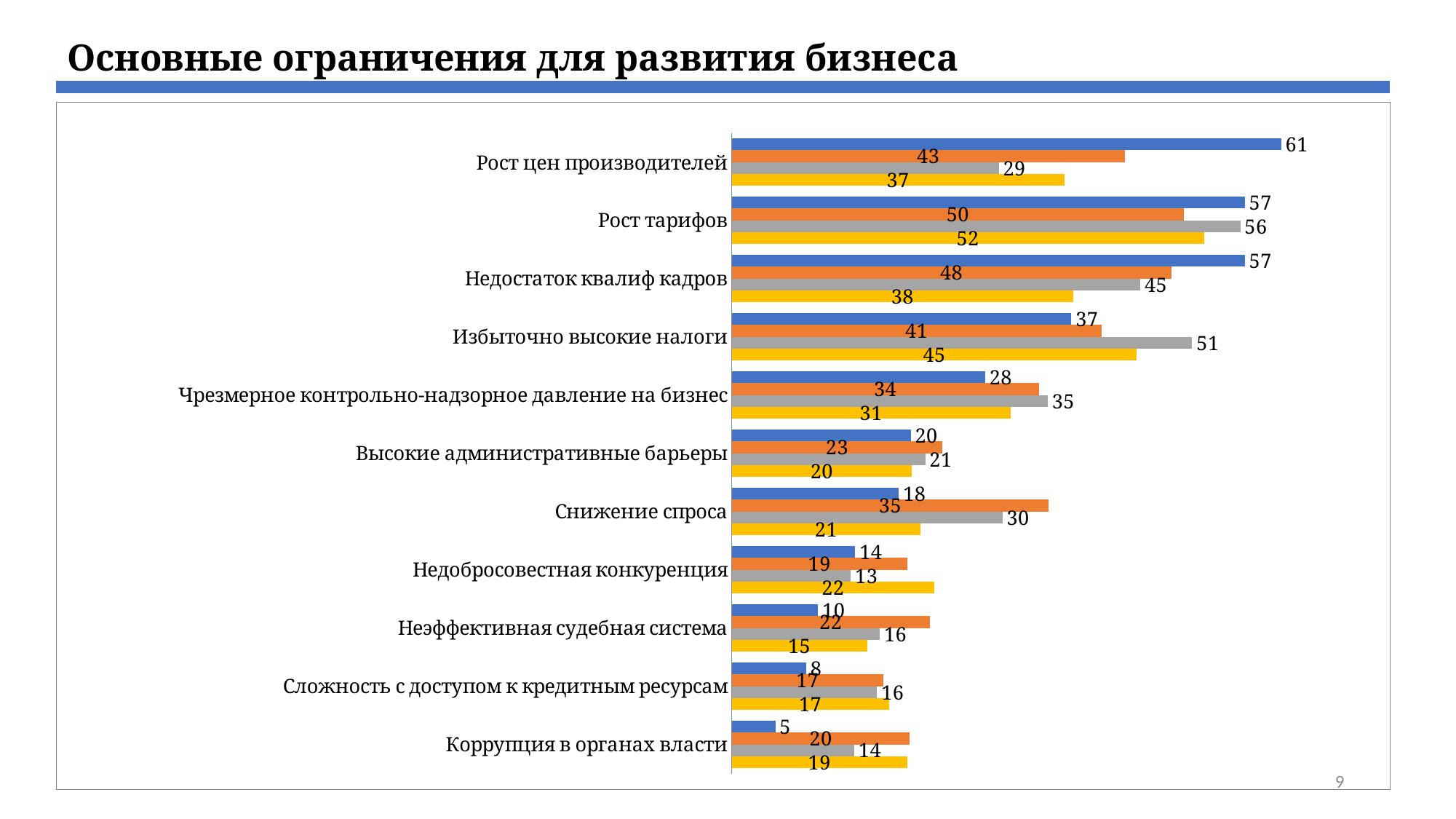
What is the value of the yellow bar for 'Рост тарифов'? 52 Which is larger for 'Избыточно высокие налоги': the blue bar or the gray bar? the gray bar What is the difference between the blue bar and the gray bar for 'Рост цен производителей'? 32 Which category has the highest blue bar value? Рост цен производителей What is the value of the blue bar for 'Рост цен производителей'? 61 How many bars are shown for each category on the chart? 4 Which category has the lowest blue bar value? Коррупция в органах власти How many categories (business constraints) are listed on the chart? 11 What is the difference between the orange bar and the blue bar for 'Коррупция в органах власти'? 15 What is the value of the orange bar for 'Снижение спроса'? 35 What type of chart is shown on the slide? bar chart What is the value of the gray bar for 'Избыточно высокие налоги'? 51